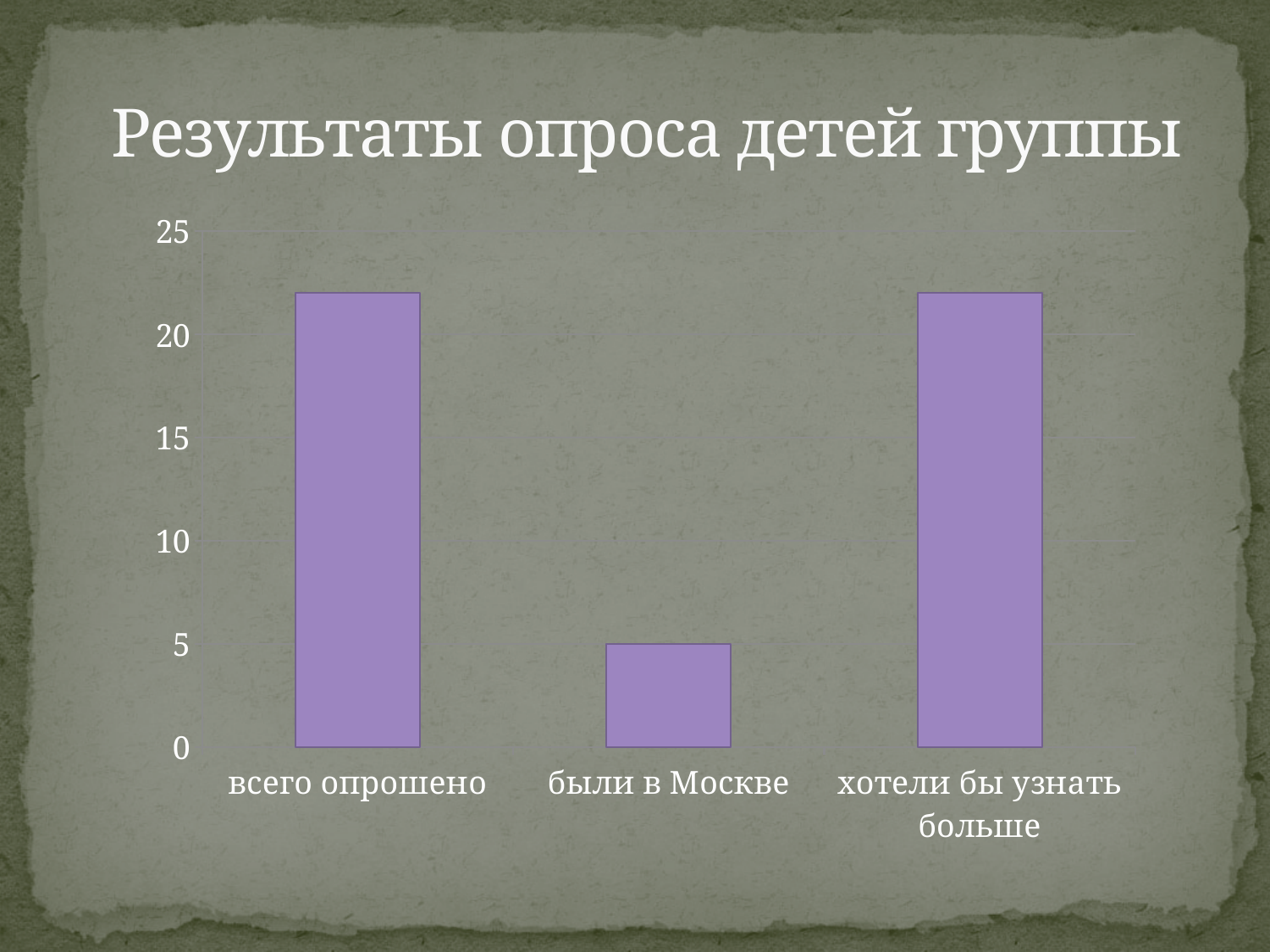
Is the value for "всего опрошено" greater or less than 20? greater What is the value for "были в Москве"? 5 Which is larger, the value for "всего опрошено" or the value for "были в Москве"? всего опрошено What is the title of the chart? Результаты опроса детей группы Which is larger, the value for "были в Москве" or the value for "хотели бы узнать больше"? хотели бы узнать больше How many categories are shown on the x axis? 3 What is the highest value shown on the y axis? 25 What colour are the bars in the chart? purple Is the value for "были в Москве" greater or less than 10? less Which category has the lowest value? были в Москве What kind of chart is shown on the slide? bar chart Is the value for "хотели бы узнать больше" greater or less than 25? less